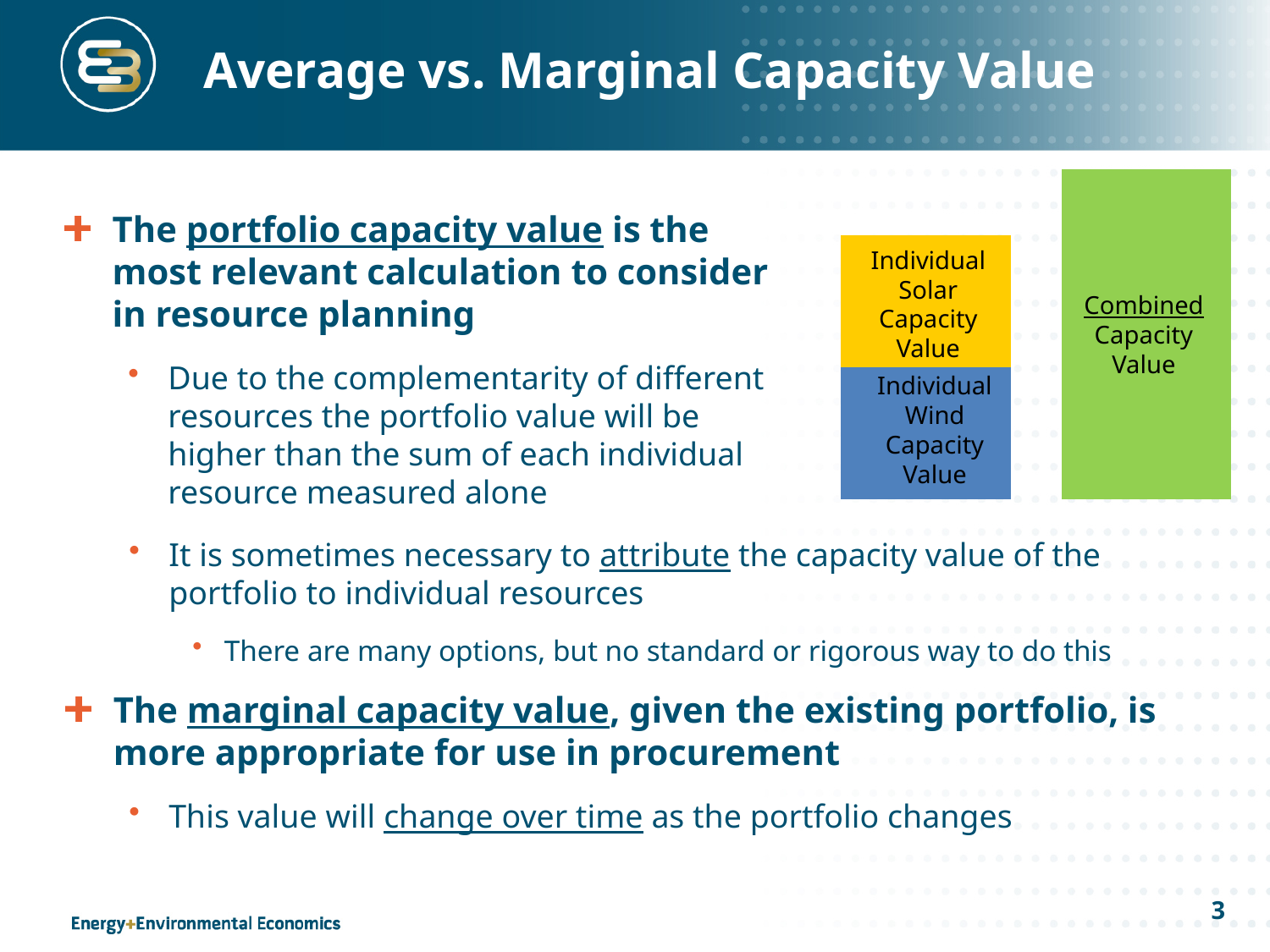
How many bars are shown in the diagram on the right side of the slide? 2 Which segment sits on top of the stacked bar in the diagram? Individual Solar Capacity Value Which bar is taller: the stacked bar of individual solar and wind capacity values, or the Combined Capacity Value bar? Combined Capacity Value What colour is the Combined Capacity Value bar? green What kind of chart is shown on the right side of the slide? bar chart Is the Individual Wind Capacity Value segment taller or shorter than the Combined Capacity Value bar? shorter